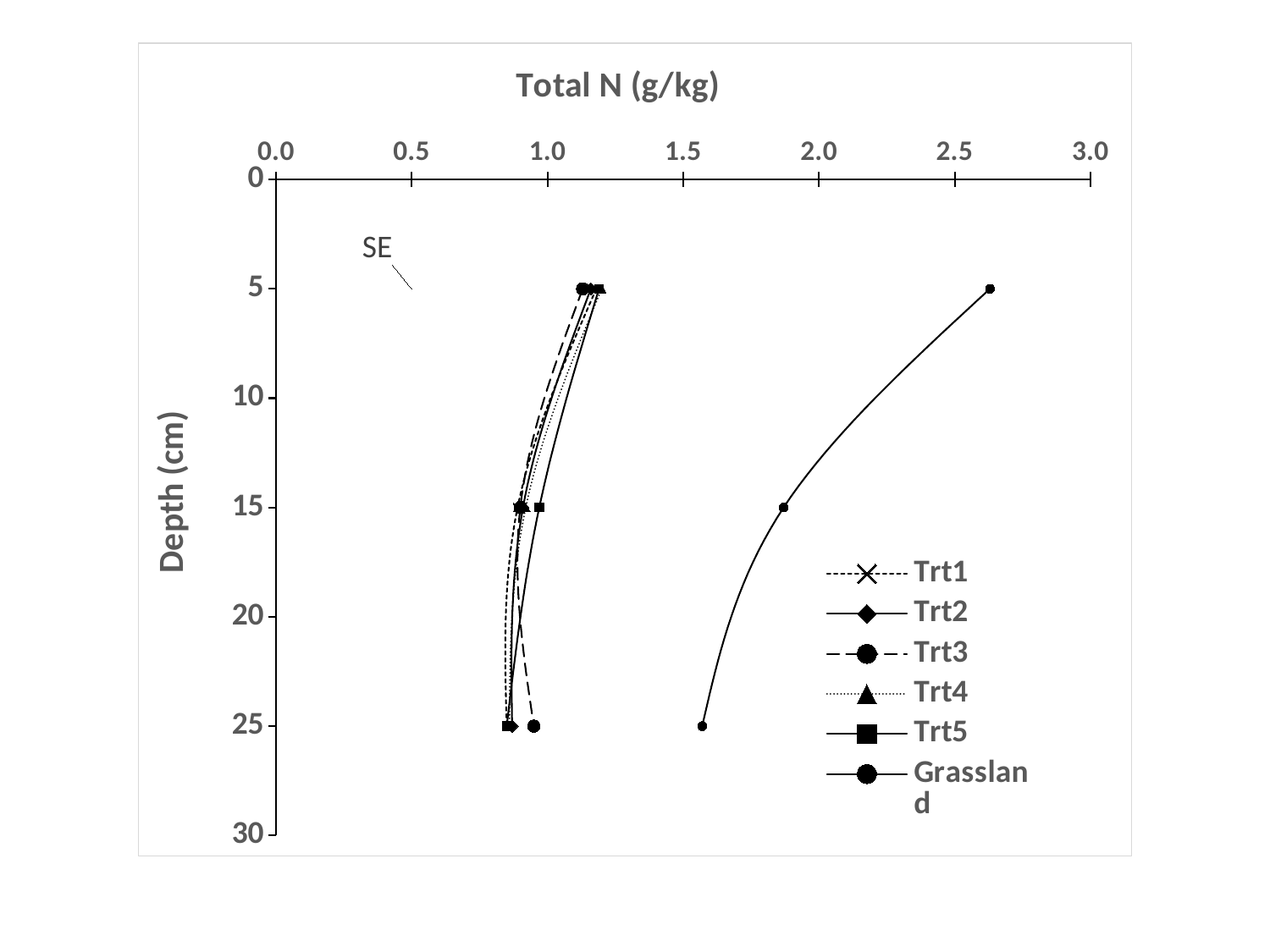
Does Total N for Grassland rise or fall as depth increases from 5 cm to 25 cm? fall Which has the larger Total N at 25 cm depth, Grassland or Trt3? Grassland What kind of chart is shown on the slide? line chart Is the Total N value for Trt5 at 5 cm depth greater or less than 1.0? greater Is the Total N value for Grassland at 15 cm depth greater or less than 2.0? less What is the title of the horizontal axis? Total N (g/kg) Is the Total N value for Grassland at 25 cm depth greater or less than 1.5? greater What is the title of the vertical axis? Depth (cm) Which series has the highest Total N at a depth of 5 cm? Grassland How many depth points are plotted for the Grassland series? 3 How many series does the legend list? 6